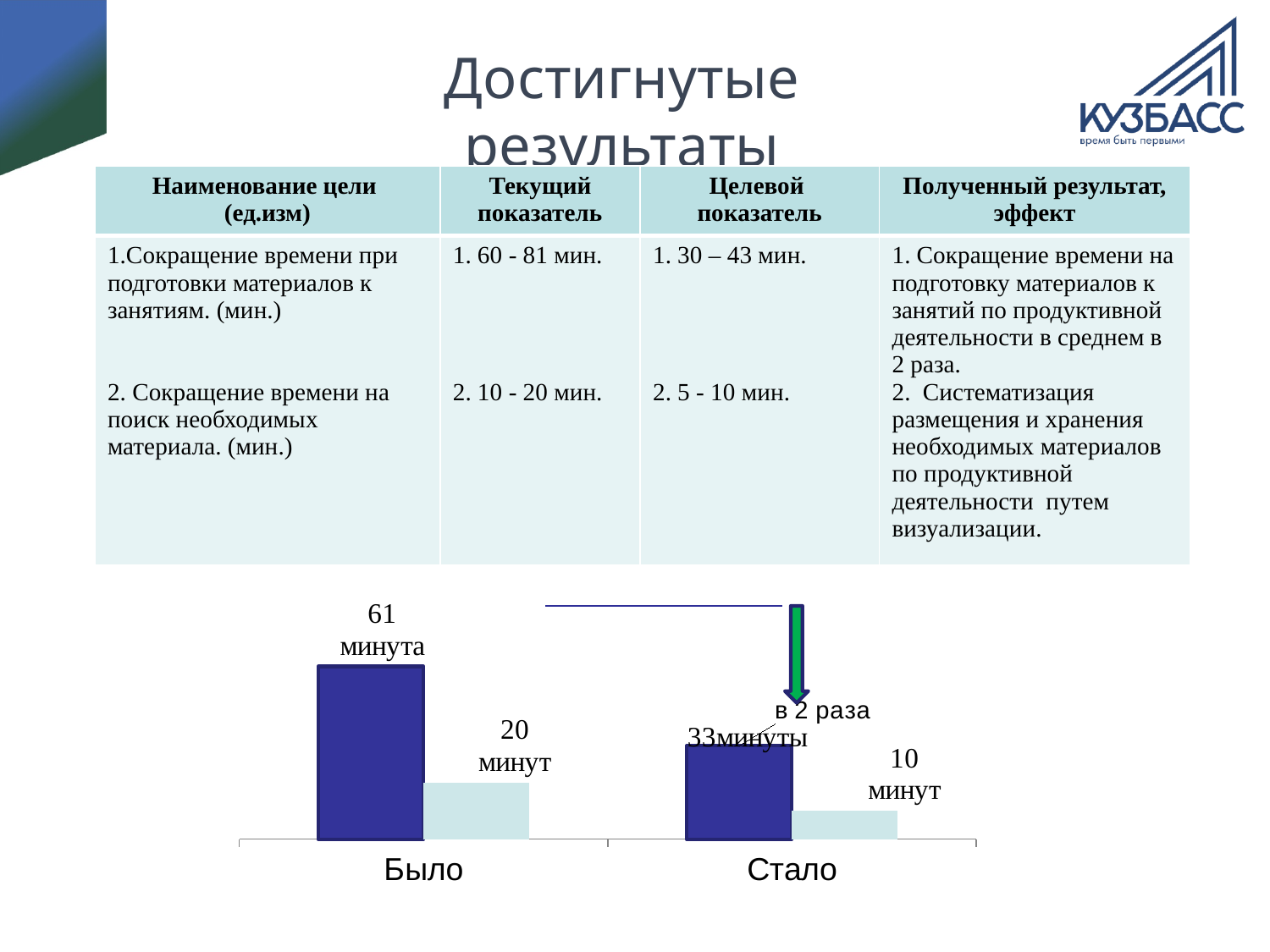
How many categories are shown on the x axis of the chart? 2 Which is larger: the dark blue bar for "Стало" or the light blue bar for "Было"? the dark blue bar for Стало What is the value of the dark blue bar for "Стало"? 33 минуты What is the value of the light blue bar for "Стало"? 10 минут Which bar in the chart is the tallest? the dark blue bar for Было (61 минута) Which bar in the chart is the shortest? the light blue bar for Стало (10 минут) What is the value of the dark blue bar for "Было"? 61 минута By how many minutes does the dark blue bar for "Было" exceed the dark blue bar for "Стало"? 28 What kind of chart is shown at the bottom of the slide? bar chart What is the value of the light blue bar for "Было"? 20 минут By how many minutes does the light blue bar for "Было" exceed the light blue bar for "Стало"? 10 Do the bar values rise or fall from "Было" to "Стало"? fall